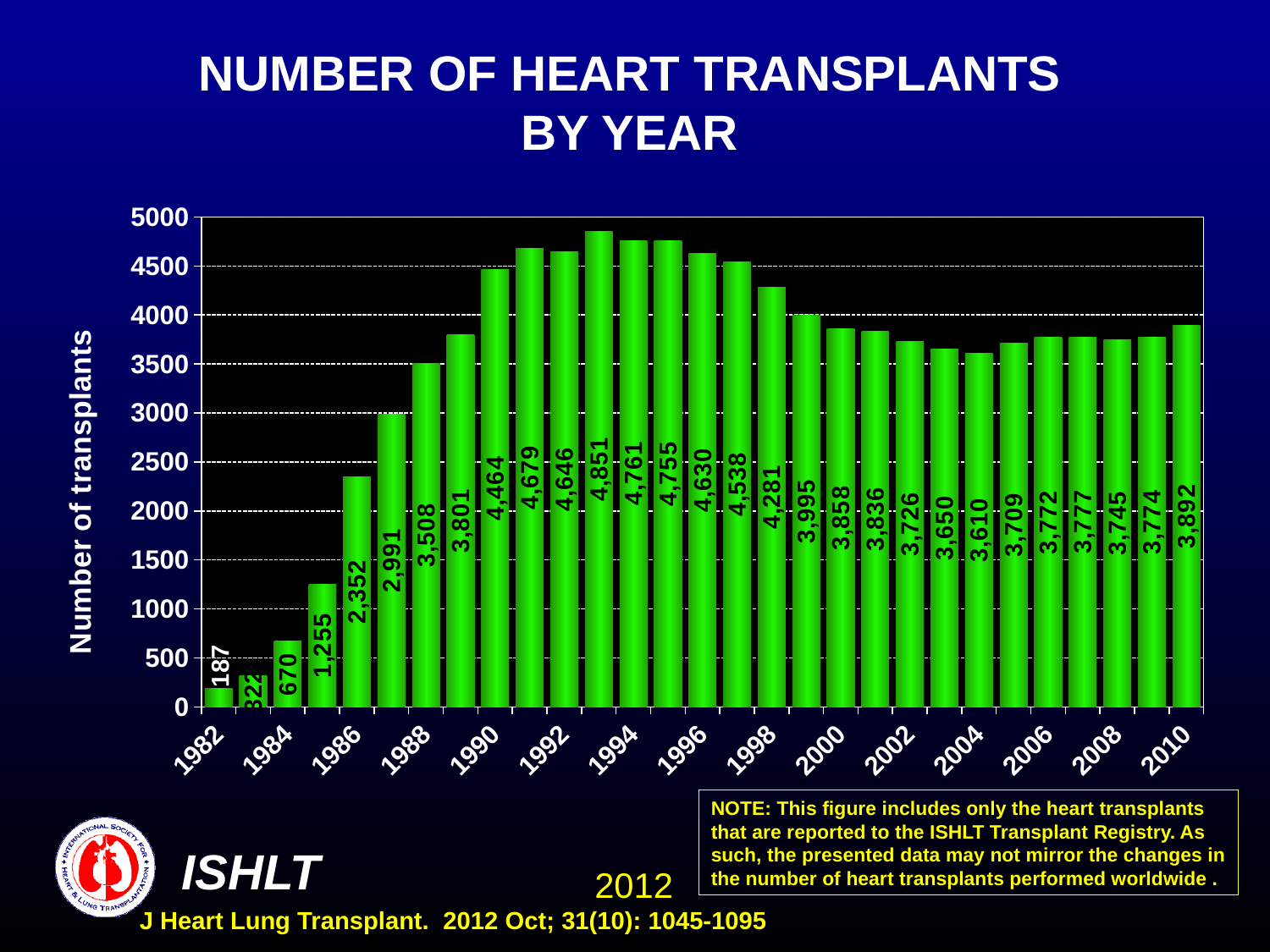
What is the number of heart transplants in 2010? 3,892 Which year had more heart transplants, 1990 or 2000? 1990 What is the number of heart transplants in 1982? 187 Which year has the lowest number of heart transplants? 1982 Is the value for 1998 greater or less than 4000? greater What is the difference between the number of heart transplants in 2010 and in 2009? 118 How many bars are shown in the chart? 29 Which year has the highest number of heart transplants? 1993 What kind of chart is shown on the slide? Bar chart What is the number of heart transplants in 1993? 4,851 What is the difference between the number of heart transplants in 1993 and in 1982? 4,664 Do the values rise or fall from 1982 to 1993? Rise